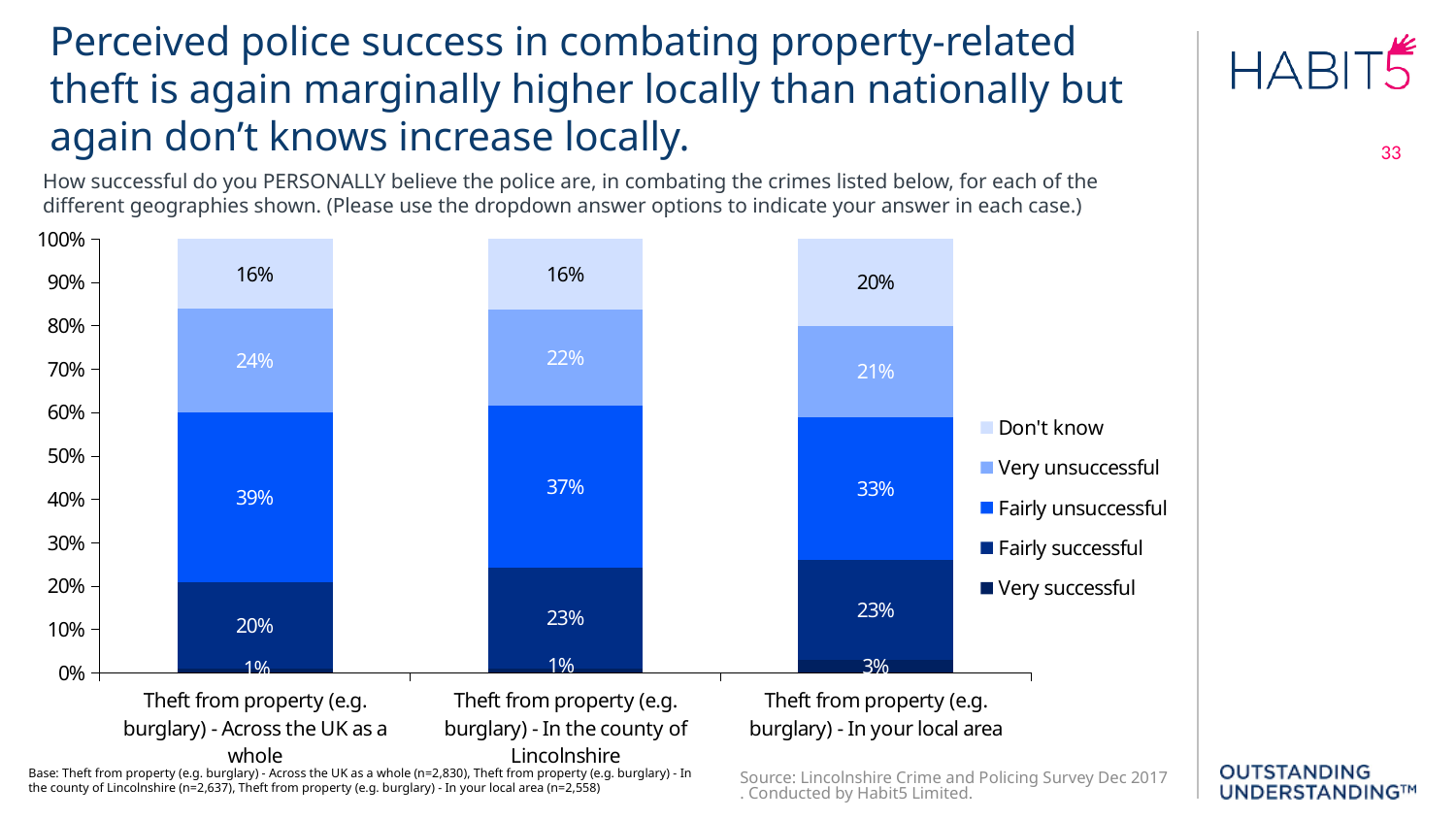
What is the difference between the 'Fairly unsuccessful' values for 'Across the UK as a whole' and 'In your local area'? 6% What is the 'Very successful' value for 'Theft from property (e.g. burglary) - In the county of Lincolnshire'? 1% How many series does the legend list? 5 Which category has the lowest 'Very unsuccessful' value? Theft from property (e.g. burglary) - In your local area What is the 'Don't know' value for 'Theft from property (e.g. burglary) - In your local area'? 20% Which category has the highest 'Fairly unsuccessful' value? Theft from property (e.g. burglary) - Across the UK as a whole Does the 'Fairly unsuccessful' value for 'Theft from property (e.g. burglary) - In your local area' fall or rise compared with 'Across the UK as a whole' moving left to right along the x axis? Fall Which is larger: the 'Very successful' value for 'In your local area' or for 'Across the UK as a whole'? In your local area What kind of chart is shown on the slide? Stacked bar chart What is the 'Fairly successful' value for 'Theft from property (e.g. burglary) - In your local area'? 23% What is the 'Fairly unsuccessful' value for 'Theft from property (e.g. burglary) - Across the UK as a whole'? 39% How many categories (bars) are shown on the x axis? 3